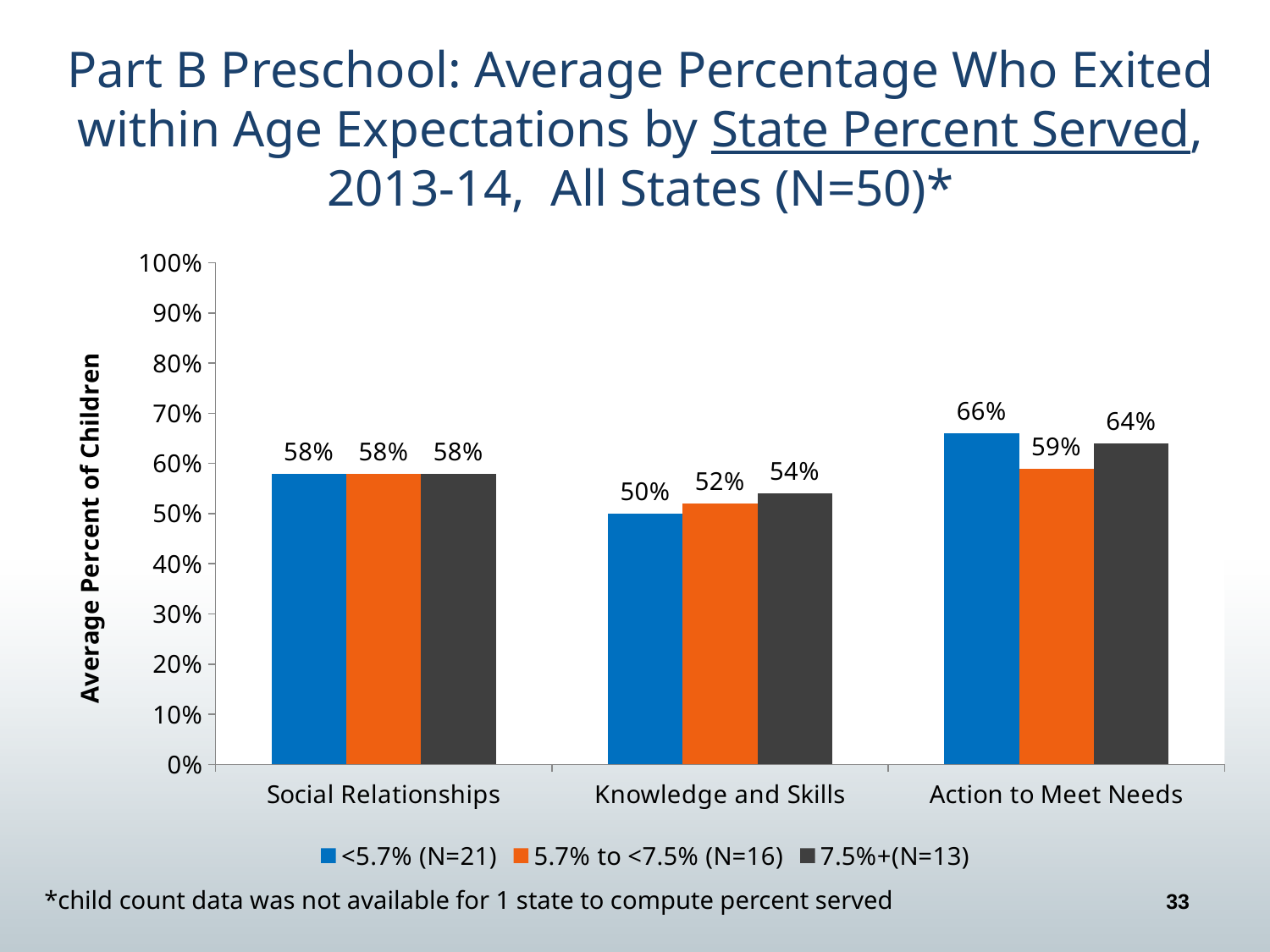
How many series does the legend list? 3 Which category has the lowest value for the 7.5%+(N=13) series? Knowledge and Skills What is the value for the <5.7% (N=21) series in the Knowledge and Skills category? 50% In the Knowledge and Skills category, which series has the larger value: <5.7% (N=21) or 7.5%+(N=13)? 7.5%+(N=13) What is the value for the 7.5%+(N=13) series in the Action to Meet Needs category? 64% Is the value for the <5.7% (N=21) series in Action to Meet Needs greater or less than 60%? greater How many categories are shown on the x axis? 3 What is the difference between the <5.7% (N=21) and 5.7% to <7.5% (N=16) values in the Action to Meet Needs category? 7% What kind of chart is shown on the slide? Bar chart What is the value for the 5.7% to <7.5% (N=16) series in the Social Relationships category? 58% What is the label of the y axis? Average Percent of Children Which category has the highest value for the <5.7% (N=21) series? Action to Meet Needs